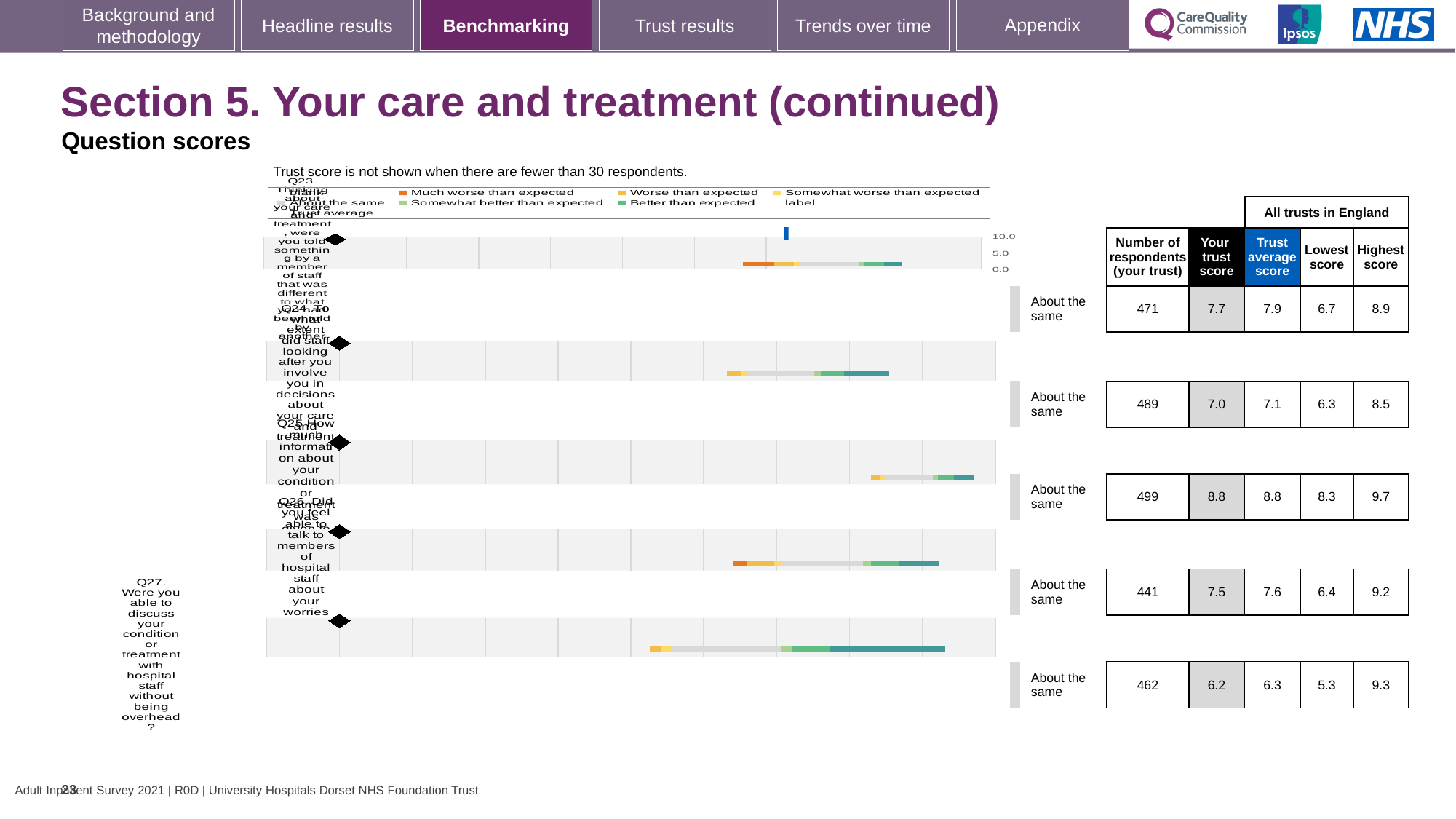
How many respondents does the table show for Q27? 462 What is the lowest score across all trusts in England for Q25? 8.3 What is the difference between the trust average score and 'Your trust score' for Q23? 0.2 Which question has the highest 'Your trust score'? Q25 How many questions (Q23 to Q27) are plotted in the chart? 5 What is the highest score across all trusts in England for Q26? 9.2 What is the 'Your trust score' value for Q24? 7.0 Which question has the lowest 'Your trust score'? Q27 What benchmark category is shown next to every question in the chart? About the same What kind of chart is used to show the question scores on this slide? bar chart What is the first entry listed in the chart legend? Much worse than expected Which is larger, the 'Your trust score' for Q23 or for Q26? Q23